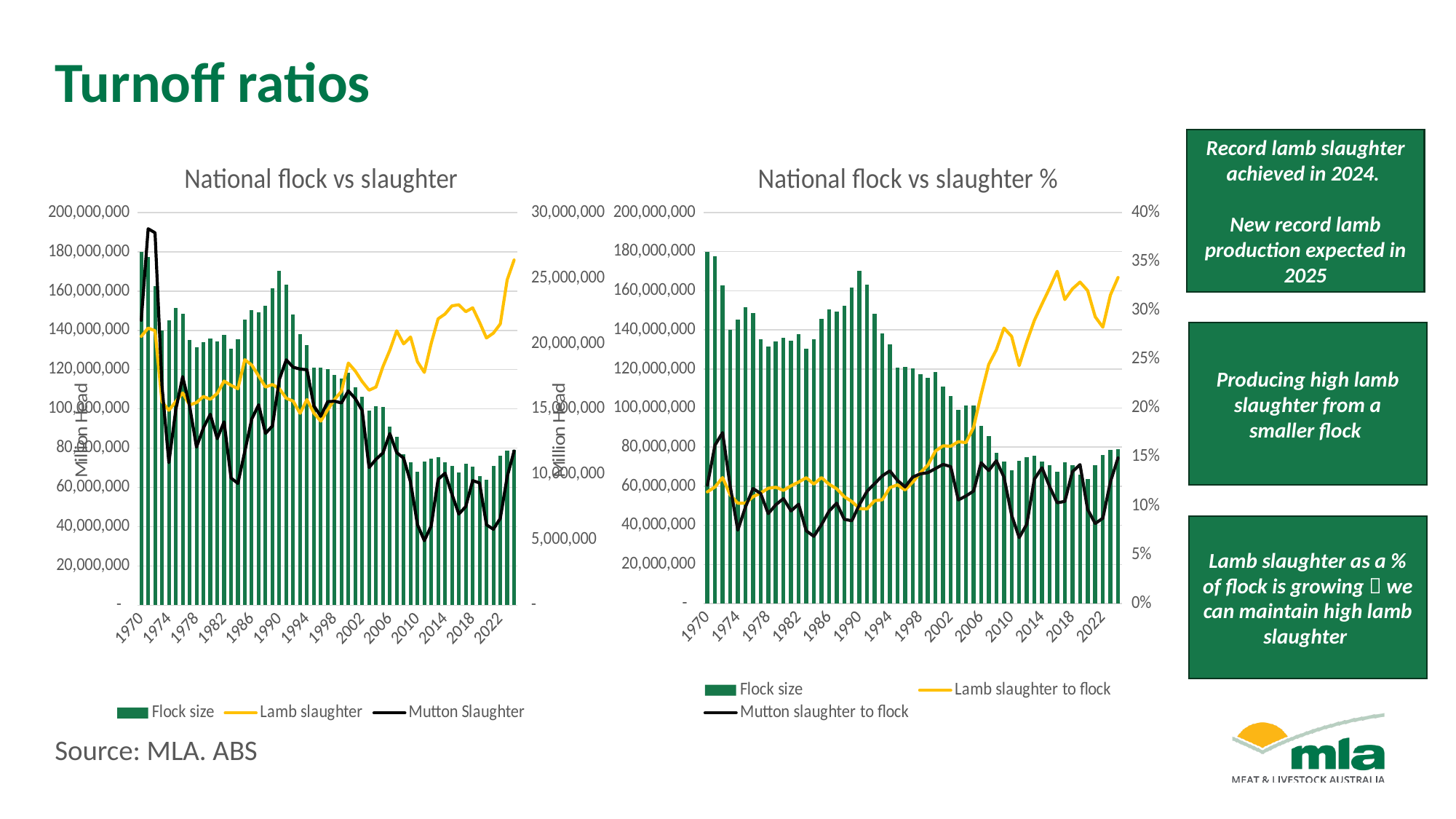
In the 'National flock vs slaughter %' chart, does lamb slaughter to flock generally rise or fall from 1970 to 2022? rise In the 'National flock vs slaughter %' chart, is lamb slaughter to flock in 1970 greater or less than 15%? less How many series does the legend of the 'National flock vs slaughter %' chart list? 3 What kind of chart is the 'National flock vs slaughter' chart on the left? A combined bar and line chart In the 'National flock vs slaughter' chart, is the lamb slaughter in 1990 greater or less than 20,000,000? less In the 'National flock vs slaughter' chart, is the flock size in 2022 greater or less than 100,000,000? less In the 'National flock vs slaughter' chart, what colour is the Lamb slaughter line? Yellow In the 'National flock vs slaughter' chart, which is larger: the flock size in 1970 or in 2022? 1970 In the 'National flock vs slaughter' chart, does the flock size generally rise or fall from 1970 to 2022? fall How many series does the legend of the 'National flock vs slaughter' chart list? 3